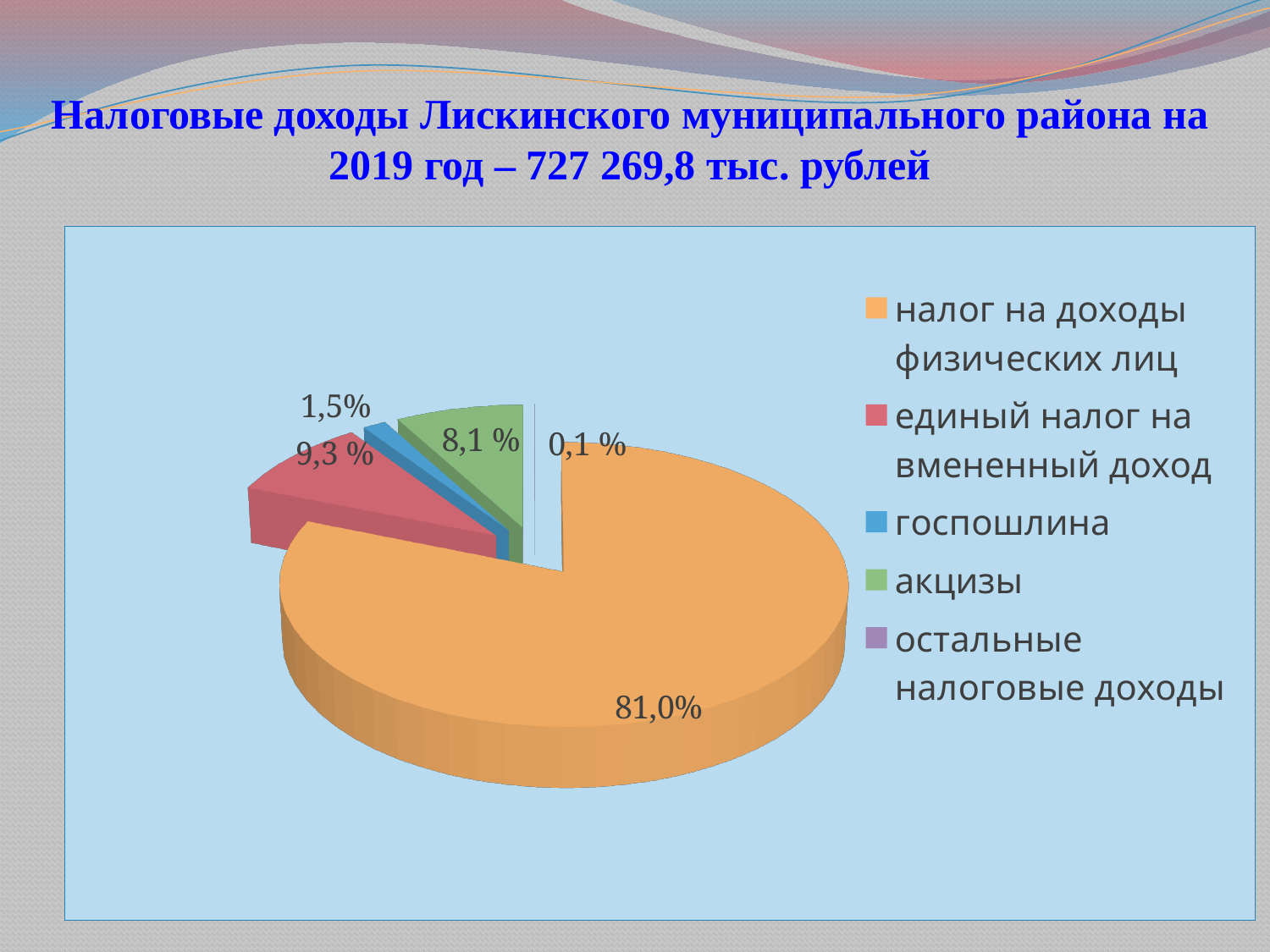
Which is larger, the share for единый налог на вмененный доход or the share for акцизы? единый налог на вмененный доход Which category has the smallest slice of the pie? остальные налоговые доходы What share of the pie does налог на доходы физических лиц have? 81,0% What share of the pie does госпошлина have? 1,5% What share of the pie does остальные налоговые доходы have? 0,1 % What is the difference in percentage points between the share for единый налог на вмененный доход and the share for акцизы? 1,2 What kind of chart is shown on the slide? pie chart Which category has the largest slice of the pie? налог на доходы физических лиц How many categories does the legend list? 5 What total amount of tax revenue for 2019 is stated in the slide title? 727 269,8 тыс. рублей